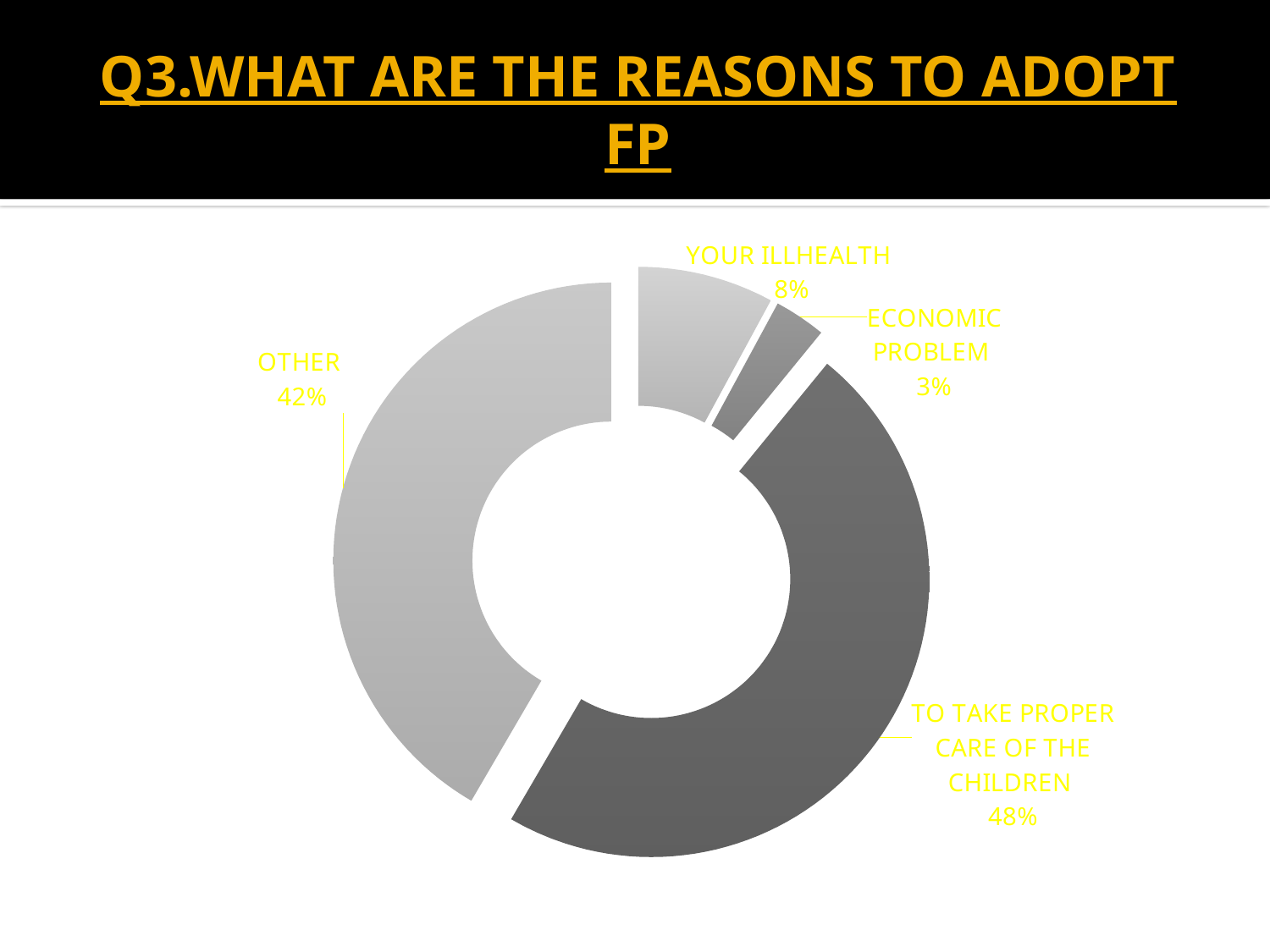
What percentage is shown for 'YOUR ILLHEALTH'? 8% Which reason has the largest share of the chart? TO TAKE PROPER CARE OF THE CHILDREN What percentage is shown for 'OTHER'? 42% How many categories are shown in the chart? 4 What is the difference in percentage points between 'TO TAKE PROPER CARE OF THE CHILDREN' and 'OTHER'? 6 What percentage is shown for 'ECONOMIC PROBLEM'? 3% What kind of chart is shown on the slide? Doughnut chart What percentage of respondents gave 'TO TAKE PROPER CARE OF THE CHILDREN' as their reason to adopt FP? 48% Which is larger: the share for 'YOUR ILLHEALTH' or the share for 'ECONOMIC PROBLEM'? YOUR ILLHEALTH What is the title of the slide? Q3.WHAT ARE THE REASONS TO ADOPT FP Which reason has the smallest share of the chart? ECONOMIC PROBLEM What is the difference in percentage points between 'YOUR ILLHEALTH' and 'ECONOMIC PROBLEM'? 5